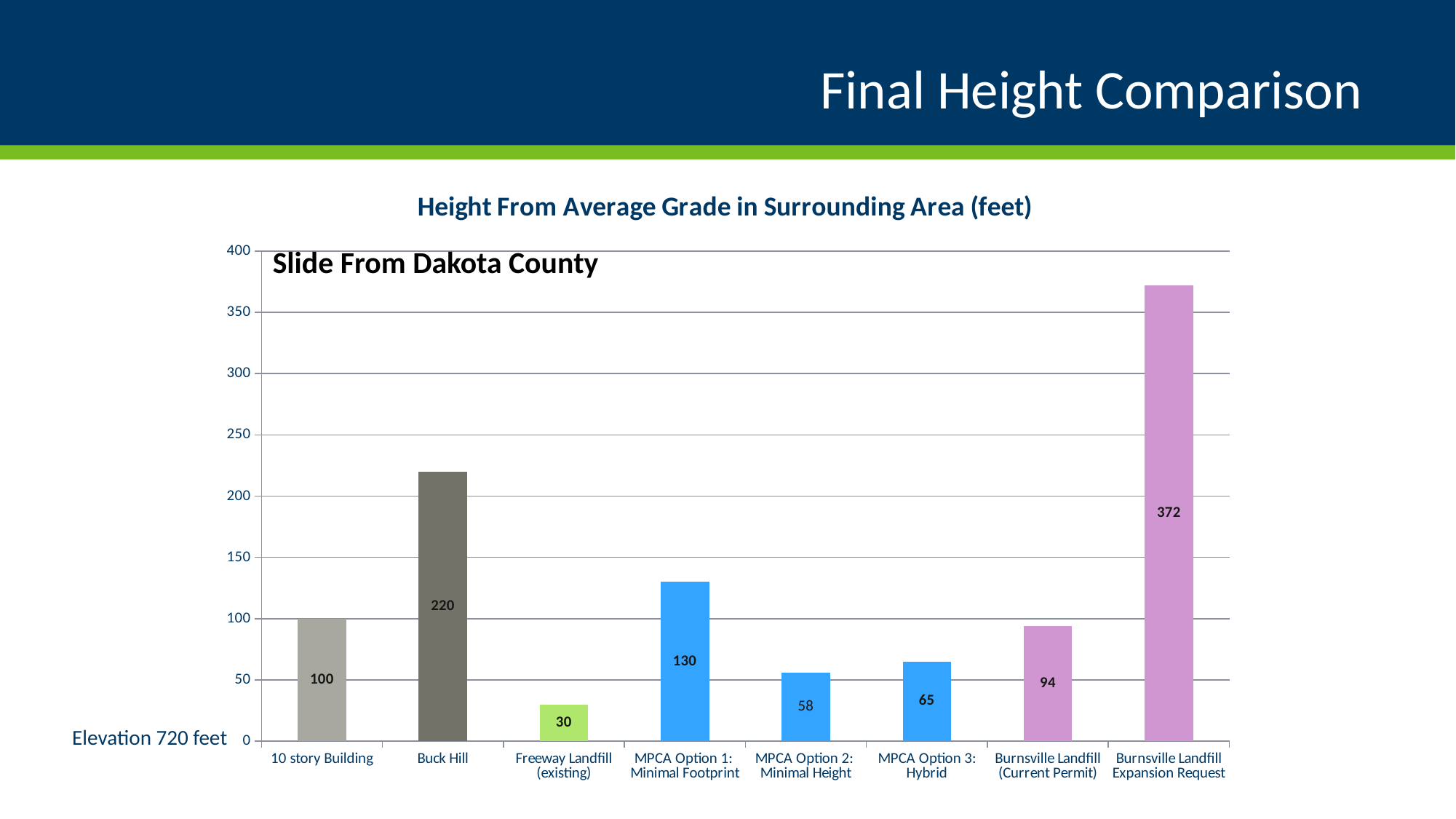
Which is larger, the value for 10 story Building or the value for Burnsville Landfill (Current Permit)? 10 story Building What is the difference between the values for Burnsville Landfill Expansion Request and Burnsville Landfill (Current Permit)? 278 What kind of chart is shown on the slide? bar chart What is the title of the chart? Height From Average Grade in Surrounding Area (feet) How many categories are shown on the x axis? 8 Is the value for Buck Hill greater or less than 200? greater Which category has the highest value? Burnsville Landfill Expansion Request What is the value for Buck Hill? 220 What is the difference between the values for MPCA Option 1: Minimal Footprint and MPCA Option 3: Hybrid? 65 Which category has the lowest value? Freeway Landfill (existing) What is the value for MPCA Option 2: Minimal Height? 58 What is the value for Burnsville Landfill Expansion Request? 372